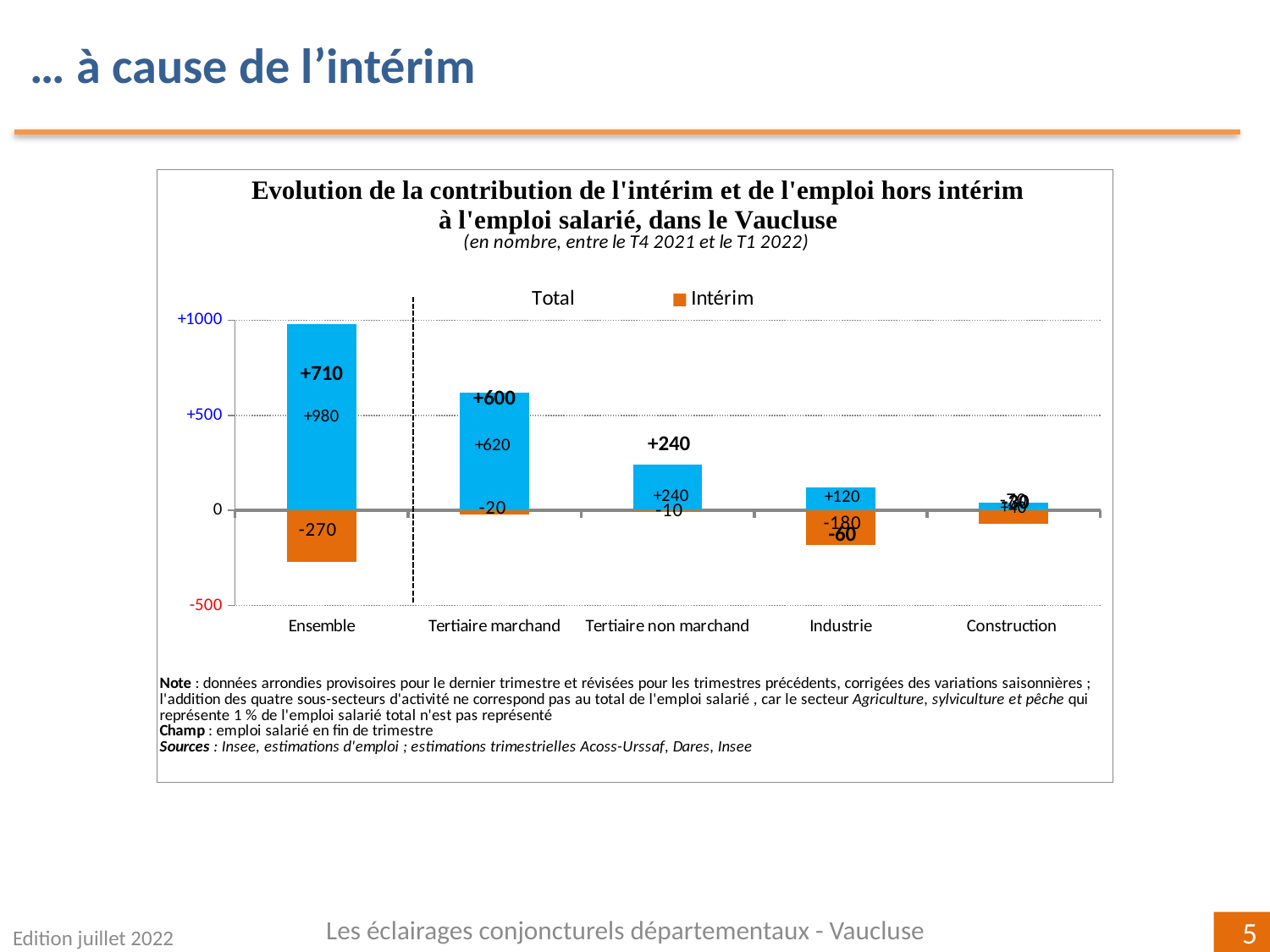
How many categories are shown on the x axis? 5 What kind of chart is shown on the slide? Bar chart What is the value of the blue bar for Ensemble? +980 What is the bold total label shown for Industrie? -60 What is the difference between the blue bar values for Ensemble and Tertiaire marchand? 360 Which category has the highest blue bar? Ensemble What is the Intérim value for Ensemble? -270 Which has the lower Intérim value, Industrie or Tertiaire marchand? Industrie What is the Intérim value for Industrie? -180 What is the bold total label shown for Ensemble? +710 Which category has the lowest Intérim value? Ensemble What is the value of the blue bar for Tertiaire marchand? +620